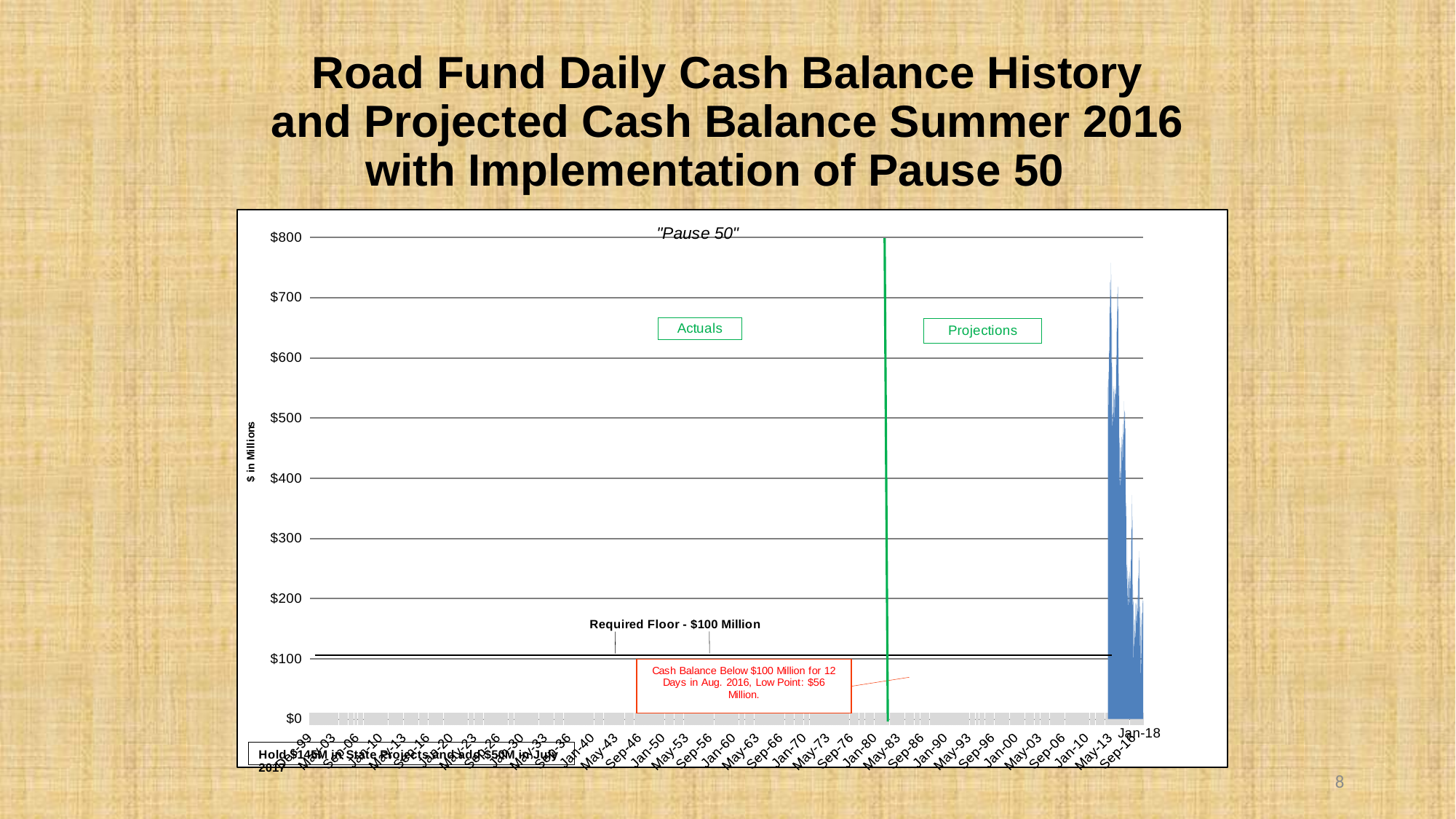
Is the low point of $56 Million noted on the chart greater or less than the $100 Million required floor? less What is the required floor value marked on the chart? $100 Million For how many days in Aug. 2016 was the cash balance below $100 million, according to the chart? 12 What is the highest value shown on the vertical axis of the chart? $800 What is the difference between the required floor of $100 Million and the low point of $56 Million noted on the chart? $44 Million What is the label of the vertical axis of the chart? $ in Millions According to the chart annotation, what was the low point of the cash balance in Aug. 2016? $56 Million What kind of chart is shown on the slide? area chart